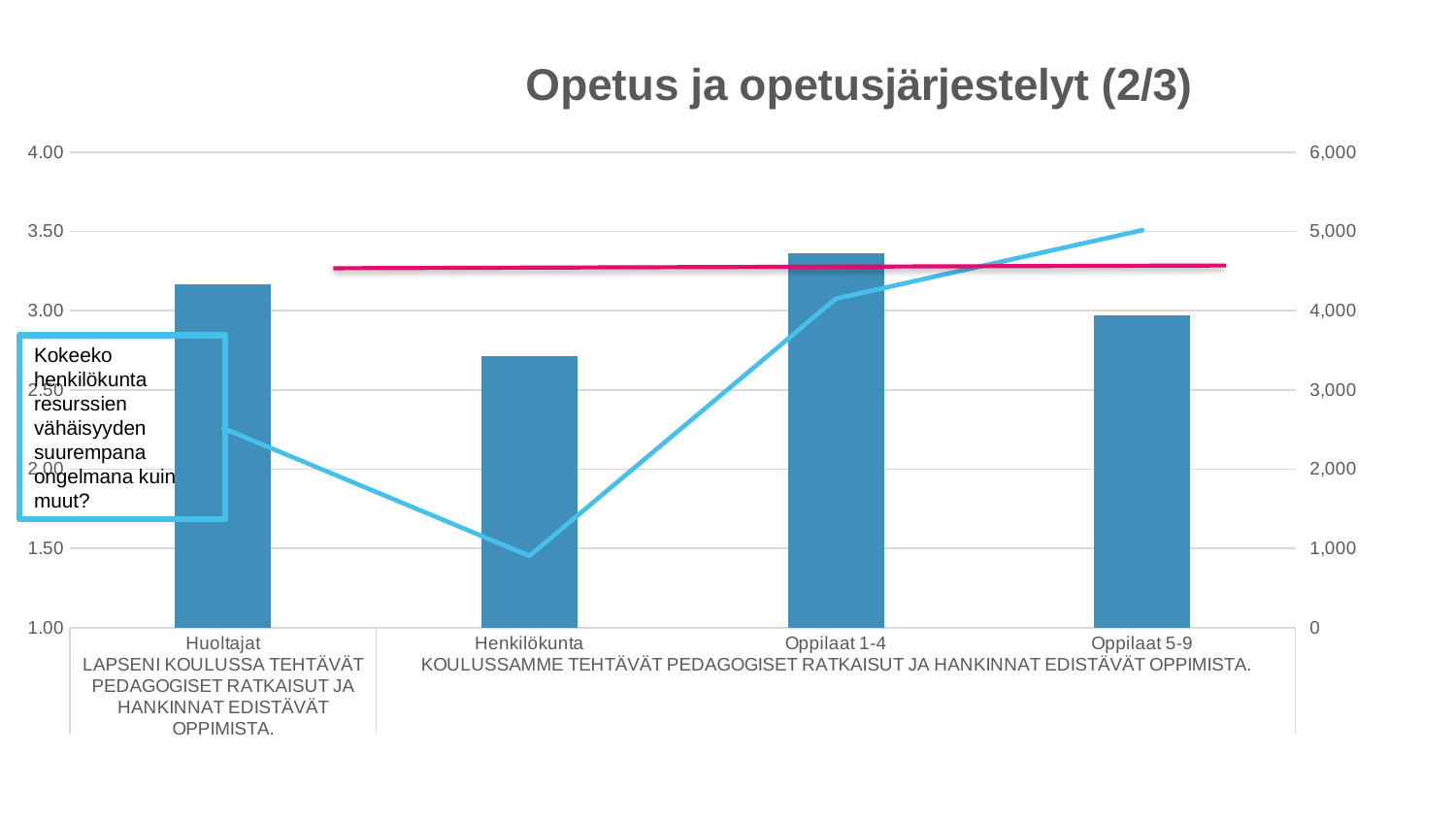
What is the title of the chart? Opetus ja opetusjärjestelyt (2/3) Which category has the highest point on the blue line (right axis)? Oppilaat 5-9 Which bar is taller, Huoltajat or Henkilökunta? Huoltajat Which category has the shortest bar? Henkilökunta Is the bar value for Henkilökunta greater or less than 3.00? less Does the blue line rise or fall from Henkilökunta to Oppilaat 5-9? rise Which category has the tallest bar? Oppilaat 1-4 Is the bar value for Oppilaat 5-9 greater or less than 2.50? greater Is the bar value for Huoltajat greater or less than 3.00? greater How many categories are shown on the x axis of the chart? 4 What kind of chart is this? Bar chart combined with a line chart Which category has the lowest point on the blue line (right axis)? Henkilökunta